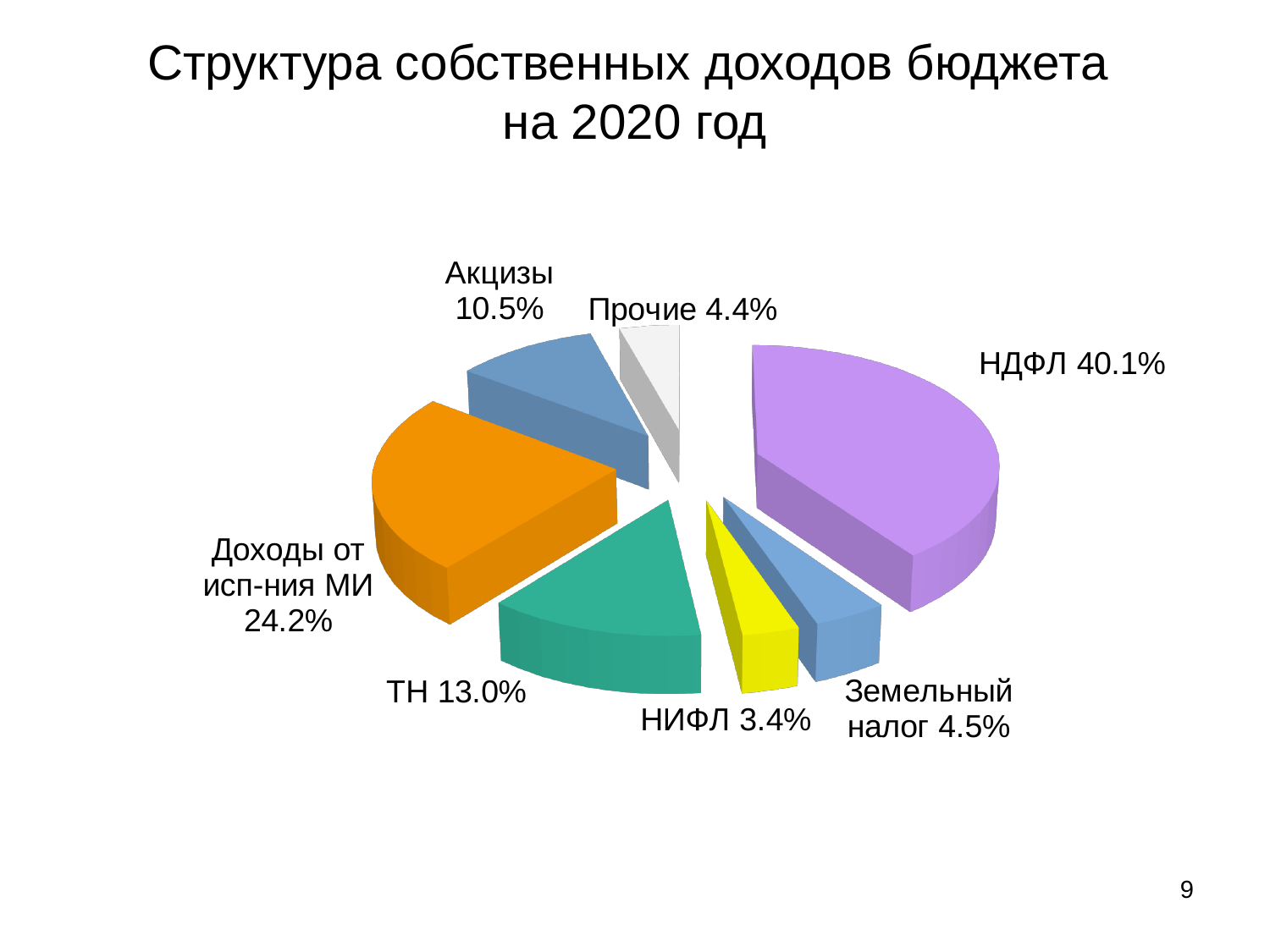
Which category has the largest share? НДФЛ Which category has the smallest share? НИФЛ How many categories are shown in the pie chart? 7 What is the share for Земельный налог? 4.5% What is the title of the chart on the slide? Структура собственных доходов бюджета на 2020 год What is the difference in percentage points between НДФЛ and Доходы от исп-ния МИ? 15.9 What is the share for Доходы от исп-ния МИ? 24.2% What is the share for Акцизы? 10.5% What share of the budget's own revenues does НДФЛ account for? 40.1% What is the difference in percentage points between Земельный налог and Прочие? 0.1 Which is larger, the share for ТН or the share for Акцизы? ТН What kind of chart is shown on the slide? Pie chart